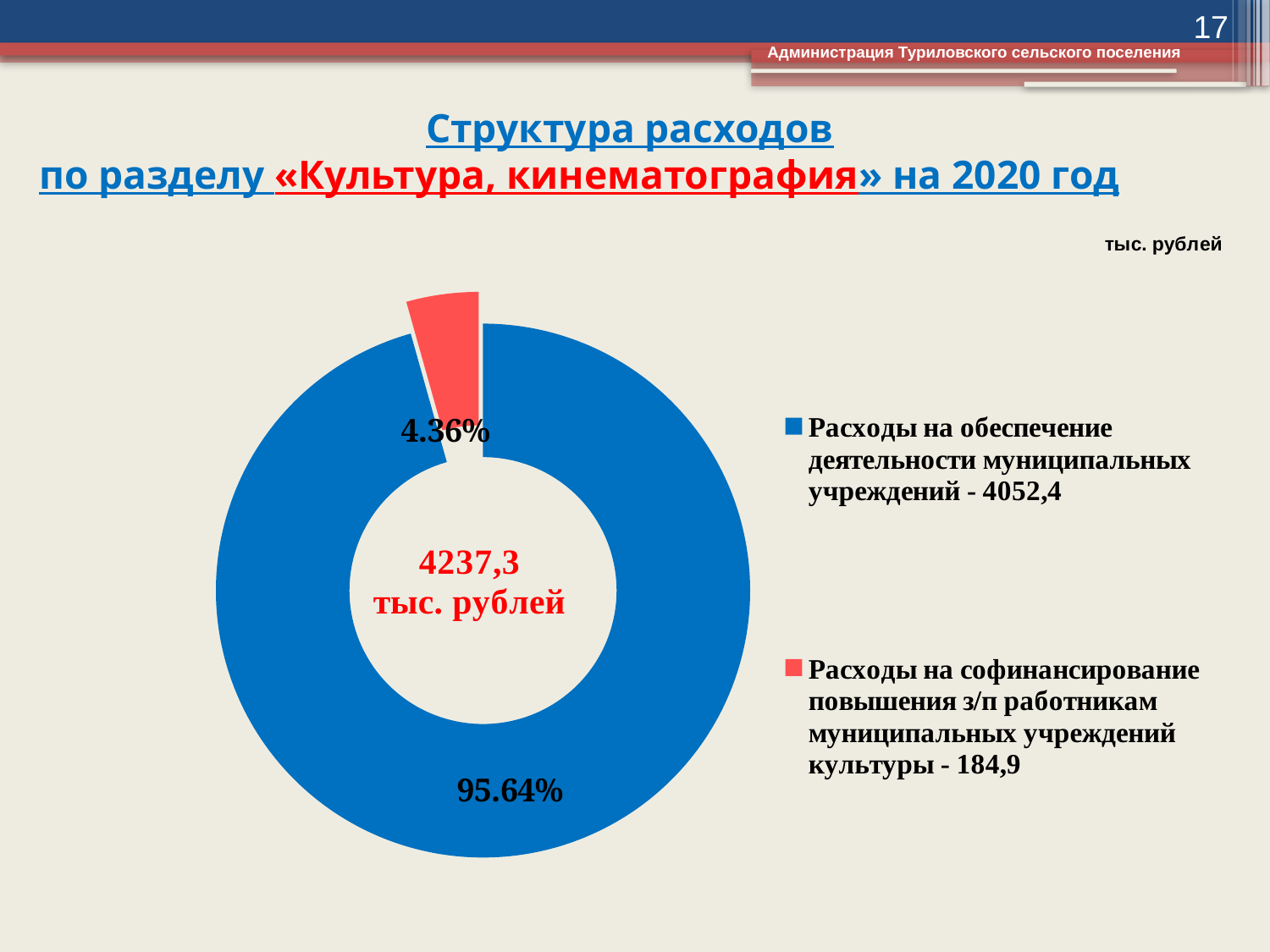
Which is larger: the value for «Расходы на обеспечение деятельности муниципальных учреждений» or for «Расходы на софинансирование повышения з/п работникам муниципальных учреждений культуры»? Расходы на обеспечение деятельности муниципальных учреждений How many categories does the chart show? 2 What share of the chart does the slice for «Расходы на обеспечение деятельности муниципальных учреждений» represent? 95.64% What value is given in the legend for «Расходы на софинансирование повышения з/п работникам муниципальных учреждений культуры»? 184,9 What is the difference in percentage points between the two slices of the chart? 91.28 What total amount is shown in the centre of the doughnut chart? 4237,3 тыс. рублей Which category has the smallest slice in the chart? Расходы на софинансирование повышения з/п работникам муниципальных учреждений культуры Which category has the largest slice in the chart? Расходы на обеспечение деятельности муниципальных учреждений What value is given in the legend for «Расходы на обеспечение деятельности муниципальных учреждений»? 4052,4 What share of the chart does the slice for «Расходы на софинансирование повышения з/п работникам муниципальных учреждений культуры» represent? 4.36% What kind of chart is shown on the slide? Doughnut (pie) chart What colour is the slice for «Расходы на софинансирование повышения з/п работникам муниципальных учреждений культуры»? Red